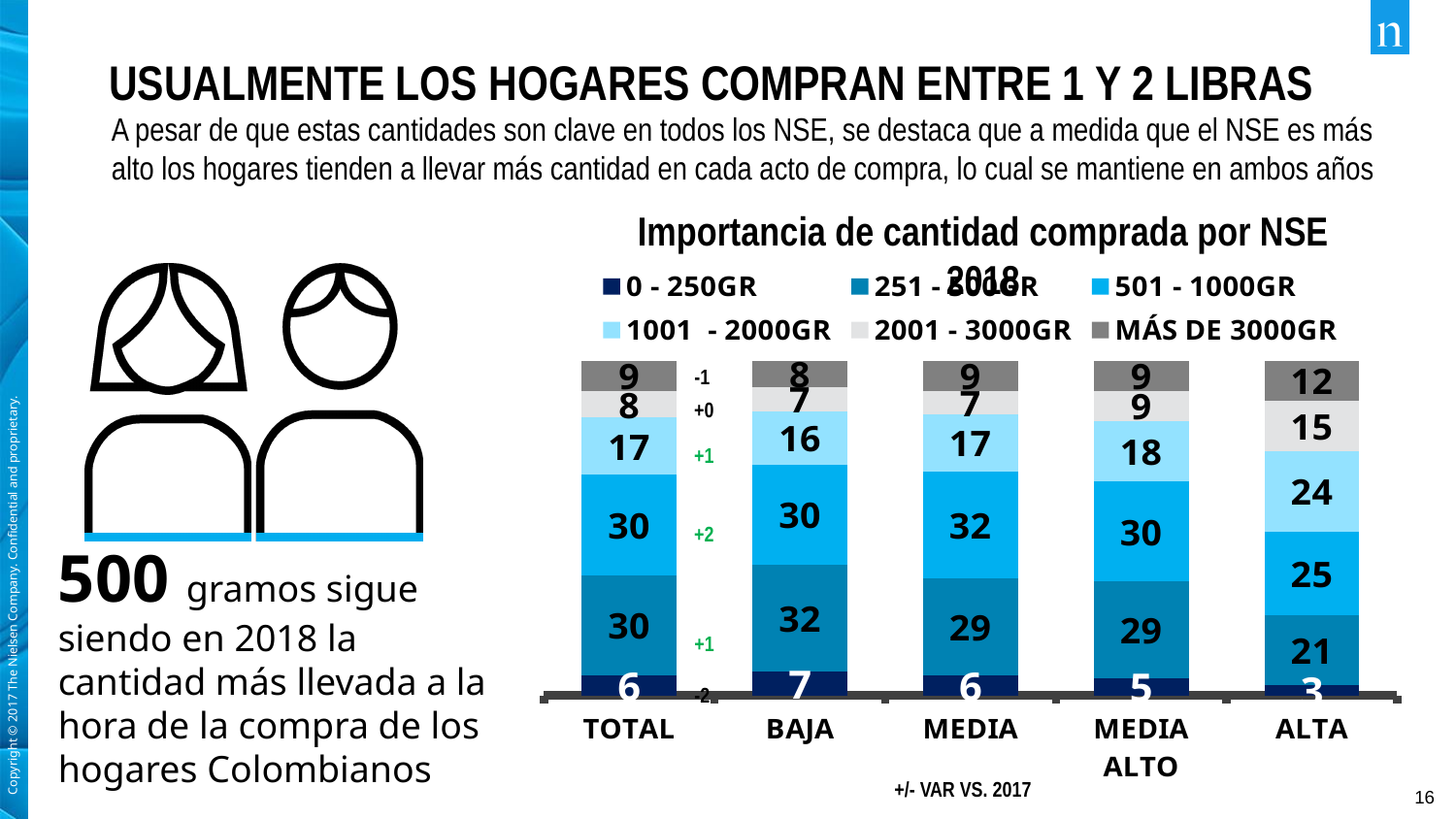
What is the value of the MÁS DE 3000GR segment for ALTA? 12 Which category has the lowest value for the 0 - 250GR segment? ALTA What is the value of the 0 - 250GR segment for MEDIA ALTO? 5 How many categories (NSE groups) are shown along the x axis of the chart? 5 Which has a larger 2001 - 3000GR value, ALTA or TOTAL? ALTA What is the value of the 501 - 1000GR segment for MEDIA? 32 Which category has the highest value for the MÁS DE 3000GR segment? ALTA What is the value of the 1001 - 2000GR segment for MEDIA ALTO? 18 What kind of chart is shown on the slide? Stacked bar chart How many series does the chart legend list? 6 What is the total of the stacked bar for TOTAL? 100 What is the difference between the 1001 - 2000GR values for ALTA and BAJA? 8